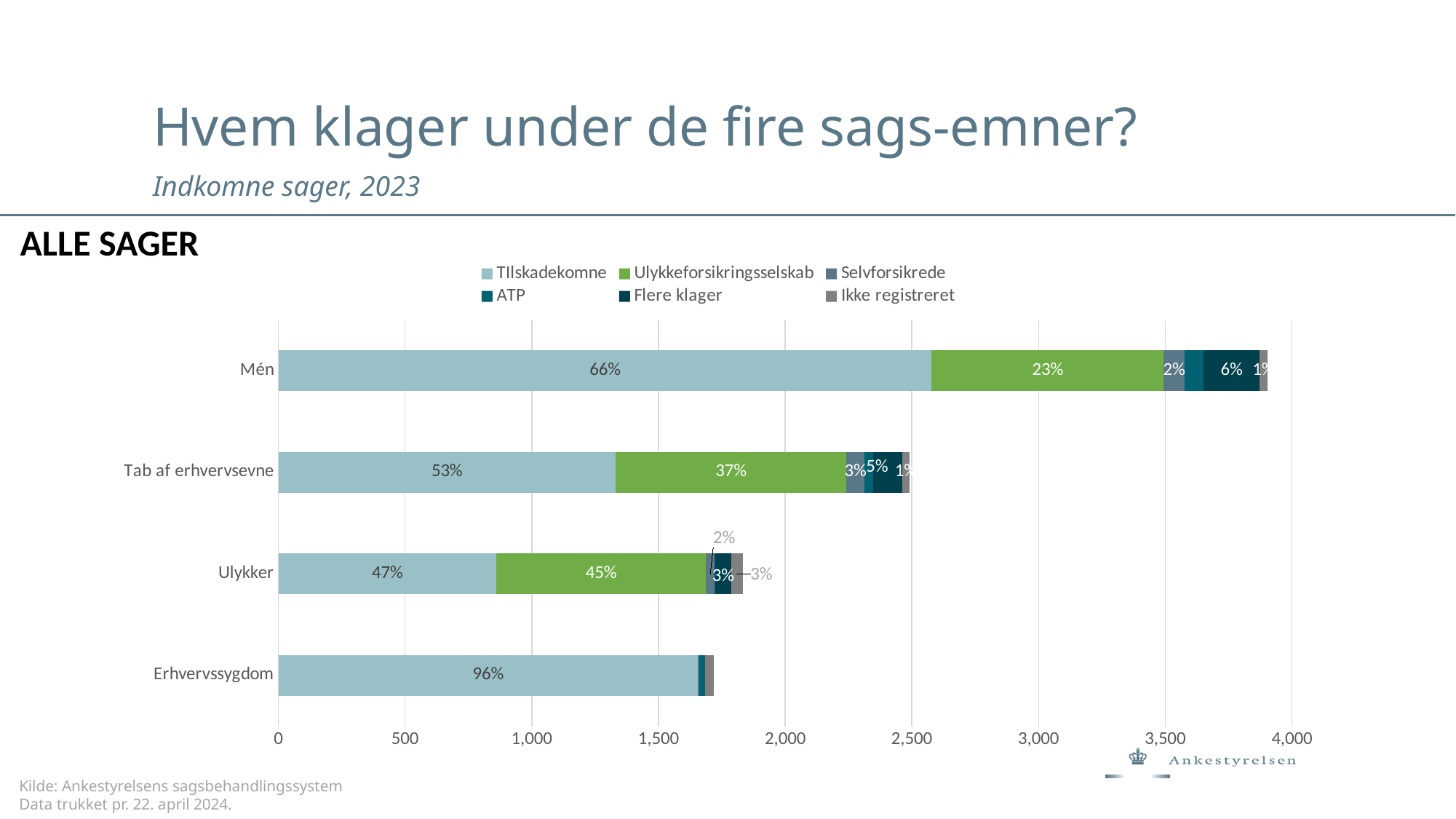
How many categories are shown on the vertical axis? 4 What is the Ulykkeforsikringsselskab share for Tab af erhvervsevne? 37% How many series does the legend list? 6 What is the Tilskadekomne share for Erhvervssygdom? 96% What is the Flere klager share for Mén? 6% Which category has the longest total bar? Mén What kind of chart is shown on the slide? Stacked bar chart What is the Tilskadekomne share for Mén? 66% Is the total bar length for Mén greater or less than 3,500? greater Is the total bar length for Ulykker greater or less than 2,000? less What is the difference in percentage points between the Tilskadekomne share (66%) and the Ulykkeforsikringsselskab share (23%) for Mén? 43 percentage points What is the Ulykkeforsikringsselskab share for Ulykker? 45%